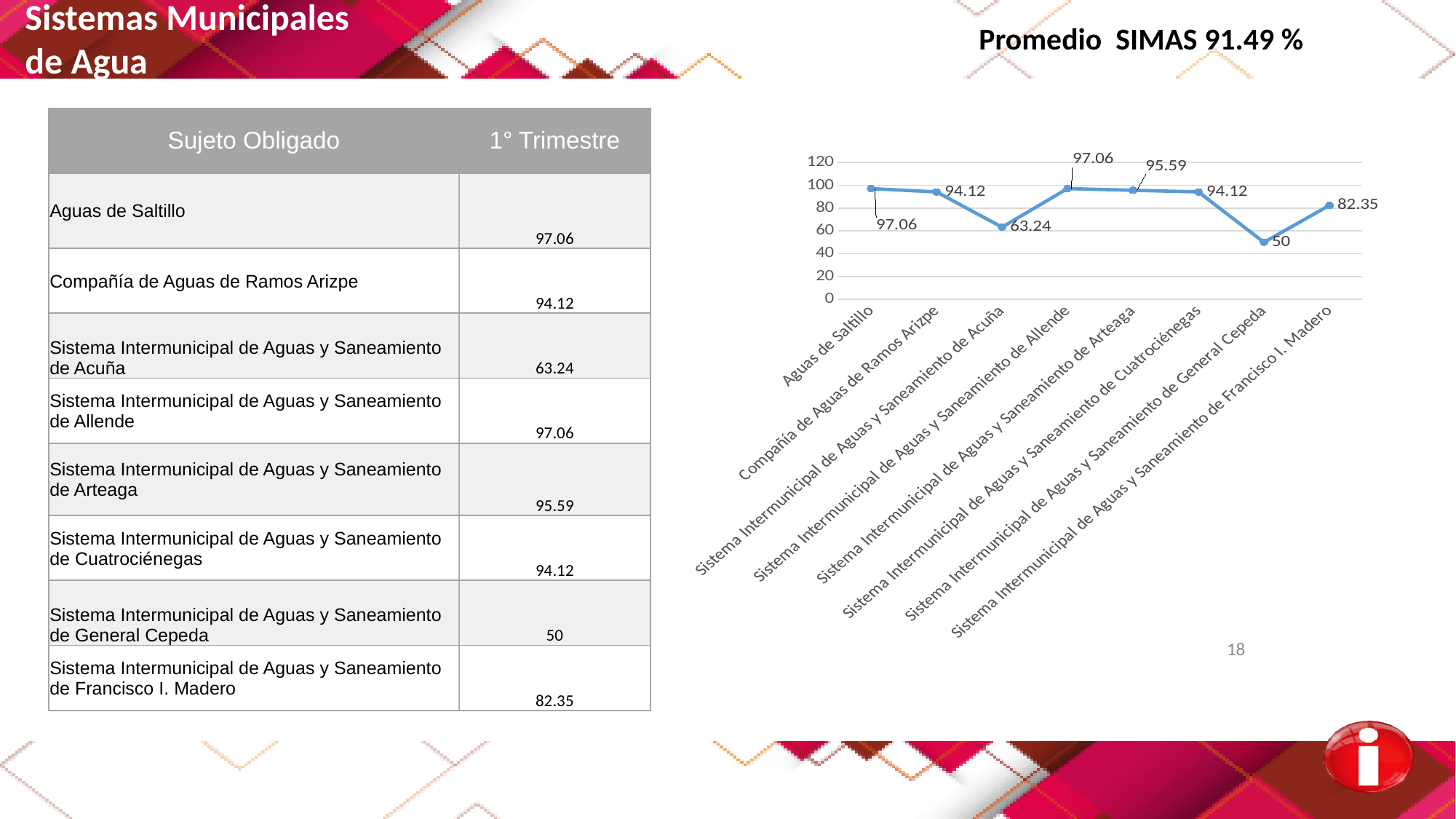
Is the value for Sistema Intermunicipal de Aguas y Saneamiento de General Cepeda greater or less than 60? less What is the value for Aguas de Saltillo on the chart? 97.06 How many categories are plotted on the chart? 8 What is the difference between the values for Sistema Intermunicipal de Aguas y Saneamiento de Francisco I. Madero and Sistema Intermunicipal de Aguas y Saneamiento de General Cepeda? 32.35 What is the difference between the values for Sistema Intermunicipal de Aguas y Saneamiento de Allende and Sistema Intermunicipal de Aguas y Saneamiento de Acuña? 33.82 Which category has the lowest value on the chart? Sistema Intermunicipal de Aguas y Saneamiento de General Cepeda What is the value for Sistema Intermunicipal de Aguas y Saneamiento de Arteaga? 95.59 What is the highest value plotted on the chart? 97.06 What is the value for Sistema Intermunicipal de Aguas y Saneamiento de Acuña? 63.24 What is the value for Sistema Intermunicipal de Aguas y Saneamiento de Francisco I. Madero? 82.35 What kind of chart is shown on the slide? line chart Which is larger, the value for Compañía de Aguas de Ramos Arizpe or the value for Sistema Intermunicipal de Aguas y Saneamiento de Francisco I. Madero? Compañía de Aguas de Ramos Arizpe